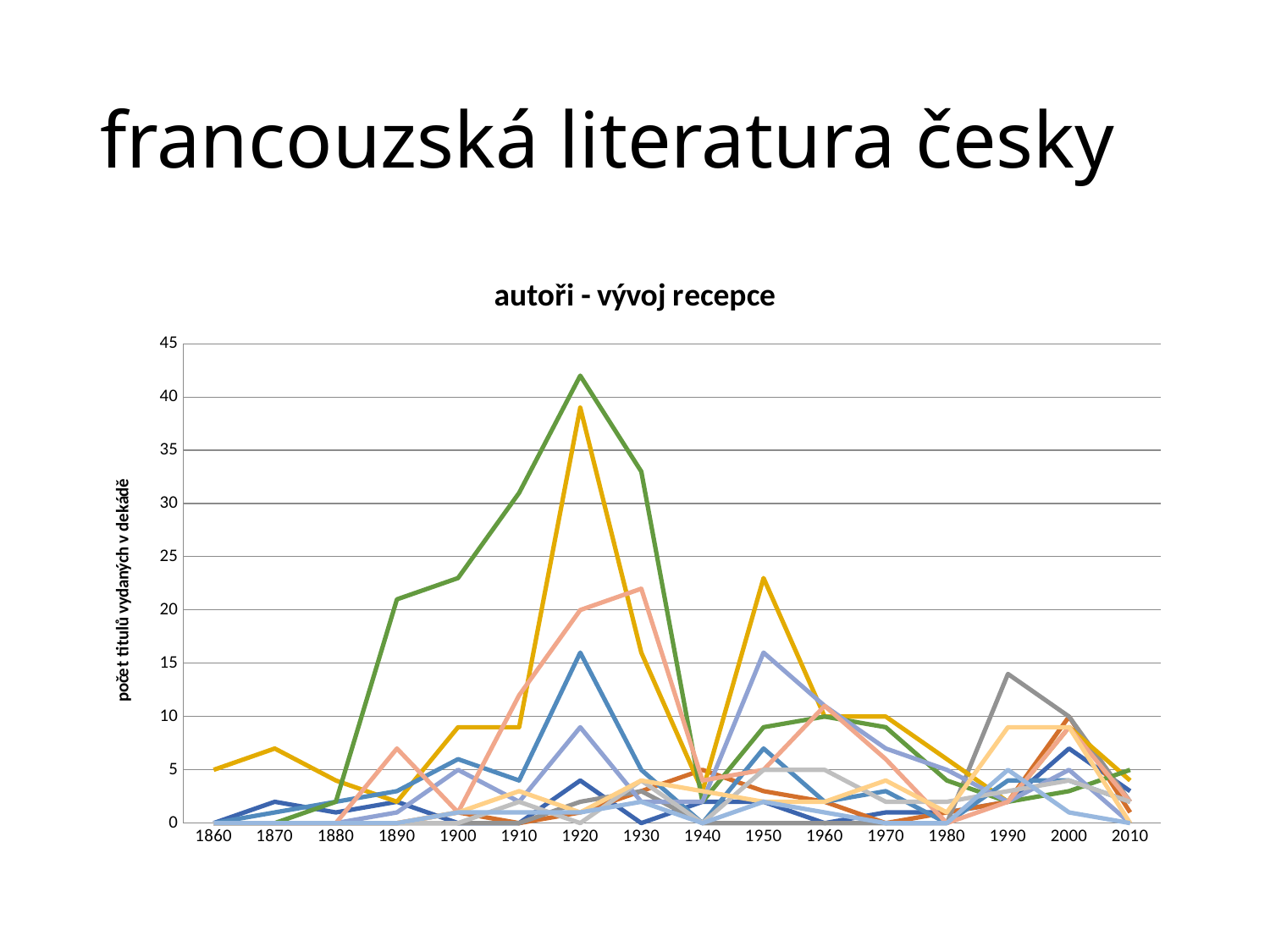
Does the green line rise or fall between 1880 and 1920? rises Is the value of the green line in 1890 greater or less than 20? greater Does the green line rise or fall between 1920 and 1940? falls What kind of chart is shown on the slide? line chart Is the value of the yellow line in 1920 greater or less than 35? greater Is the value of the yellow line in 1950 greater or less than 20? greater How many decades are marked along the x axis of the chart? 16 In which year does the green line reach its highest value? 1920 What is the title of the chart? autoři - vývoj recepce What is the label on the vertical axis of the chart? počet titulů vydaných v dekádě In which year does any line on the chart reach the highest value overall? 1920